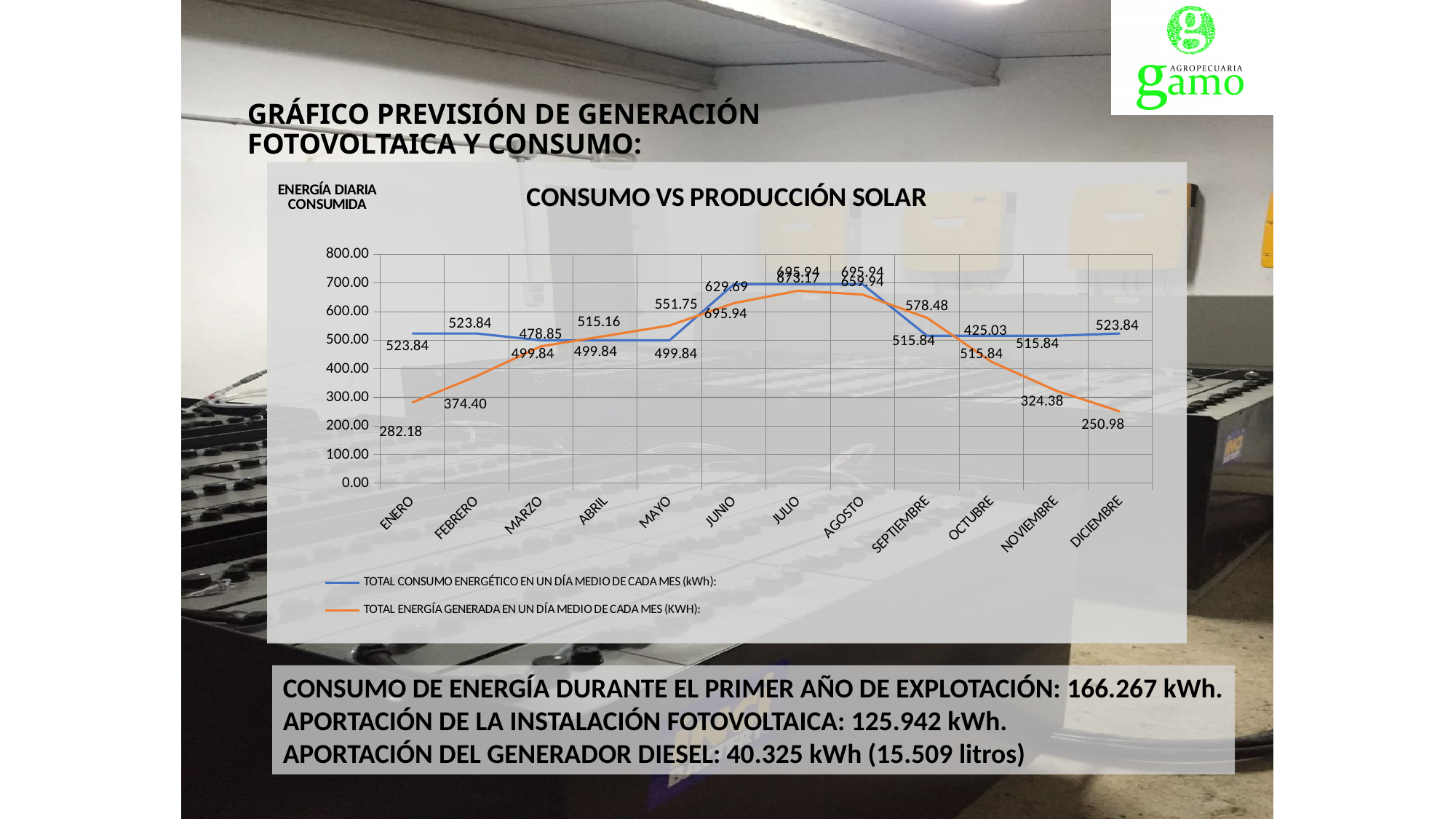
What is the value of TOTAL ENERGÍA GENERADA EN UN DÍA MEDIO DE CADA MES for DICIEMBRE? 250.98 How many series does the chart legend list? 2 In ABRIL, which is larger: TOTAL CONSUMO ENERGÉTICO or TOTAL ENERGÍA GENERADA? TOTAL ENERGÍA GENERADA In which month is TOTAL ENERGÍA GENERADA EN UN DÍA MEDIO DE CADA MES highest? JULIO What is the title of the chart? CONSUMO VS PRODUCCIÓN SOLAR What is the value of TOTAL CONSUMO ENERGÉTICO EN UN DÍA MEDIO DE CADA MES for ENERO? 523.84 In ENERO, what is the difference between TOTAL CONSUMO ENERGÉTICO (523.84) and TOTAL ENERGÍA GENERADA (282.18)? 241.66 How many months are plotted along the x axis? 12 What is the value of TOTAL ENERGÍA GENERADA EN UN DÍA MEDIO DE CADA MES for ENERO? 282.18 What is the value of TOTAL ENERGÍA GENERADA EN UN DÍA MEDIO DE CADA MES for SEPTIEMBRE? 578.48 What type of chart is shown on the slide? Line chart In which month is TOTAL ENERGÍA GENERADA EN UN DÍA MEDIO DE CADA MES lowest? DICIEMBRE